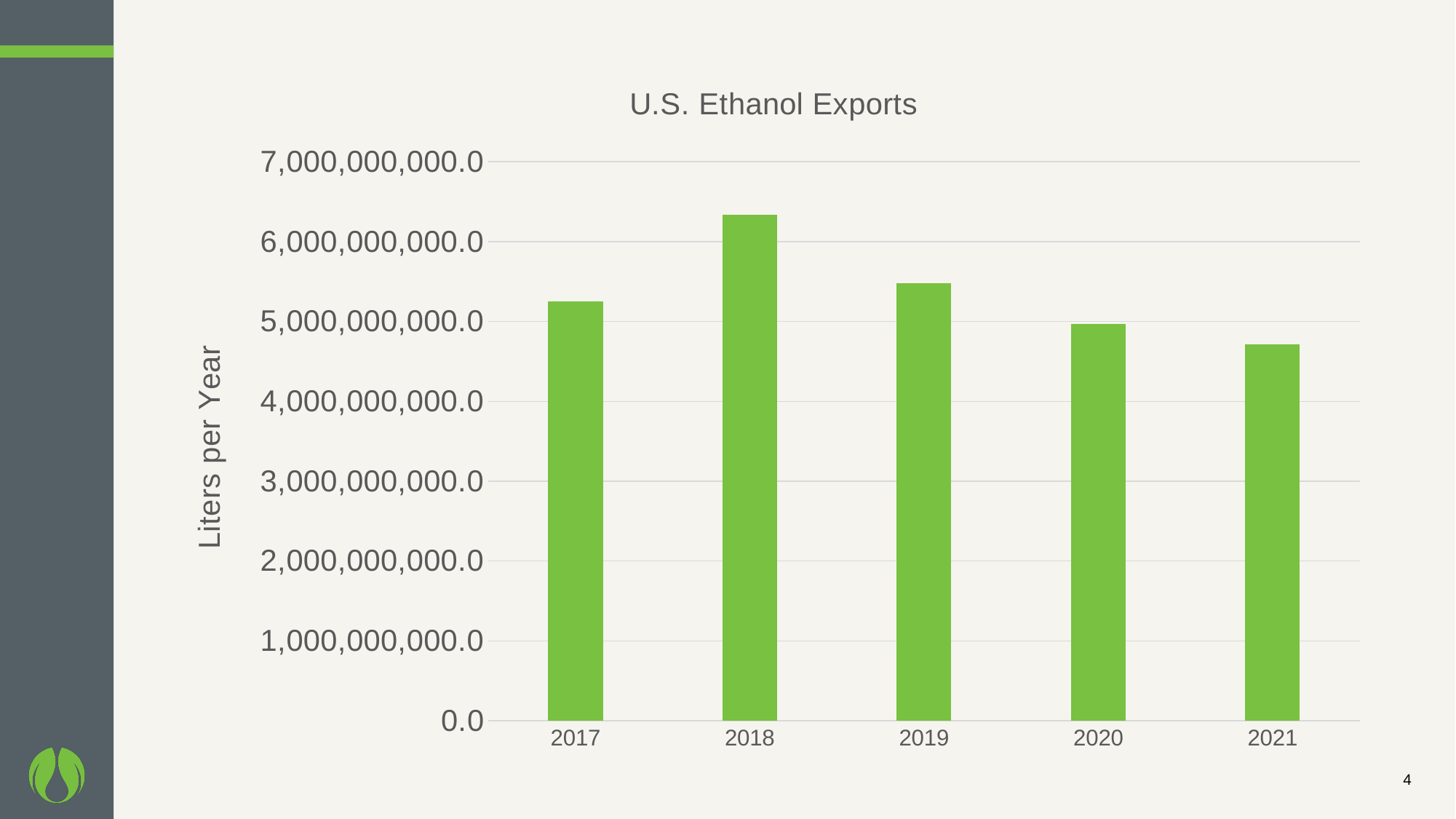
What kind of chart is shown on the slide? bar chart Do U.S. ethanol exports rise or fall from 2018 to 2021? fall How many years are shown on the x axis of the U.S. Ethanol Exports chart? 5 Which year has the highest U.S. ethanol exports? 2018 Is the value for 2018 greater or less than 6,000,000,000.0? greater Is the value for 2017 greater or less than 5,000,000,000.0? greater Which year had higher ethanol exports, 2017 or 2021? 2017 Is the value for 2021 greater or less than 5,000,000,000.0? less What is the title of the chart? U.S. Ethanol Exports Which year has the lowest U.S. ethanol exports? 2021 What is the label on the vertical axis of the chart? Liters per Year Which year had higher ethanol exports, 2018 or 2019? 2018